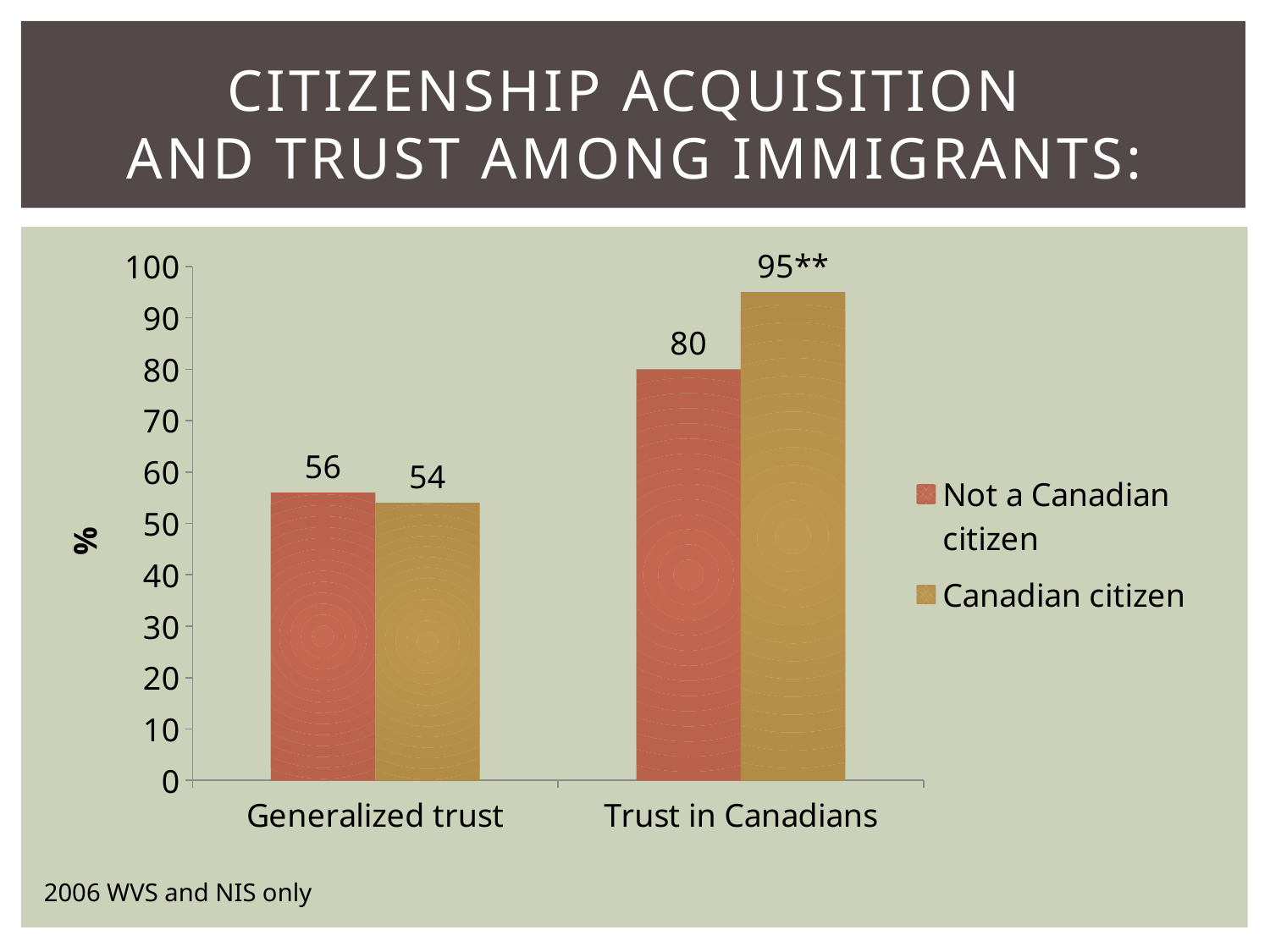
What is the value for Not a Canadian citizen in the Generalized trust category? 56 Which category has the highest value for the Canadian citizen series? Trust in Canadians How many series does the legend list? 2 What is the value for Not a Canadian citizen in the Trust in Canadians category? 80 What kind of chart is shown on the slide? Bar chart For Trust in Canadians, which series has the larger value: Not a Canadian citizen or Canadian citizen? Canadian citizen Which category has the lowest value for the Not a Canadian citizen series? Generalized trust What is the data label shown for Canadian citizen in the Trust in Canadians category? 95** Is the value for Not a Canadian citizen in Trust in Canadians greater or less than 70? greater How many categories are shown on the x axis? 2 What is the value for Canadian citizen in the Generalized trust category? 54 What is the difference between the Canadian citizen and Not a Canadian citizen values for Trust in Canadians? 15